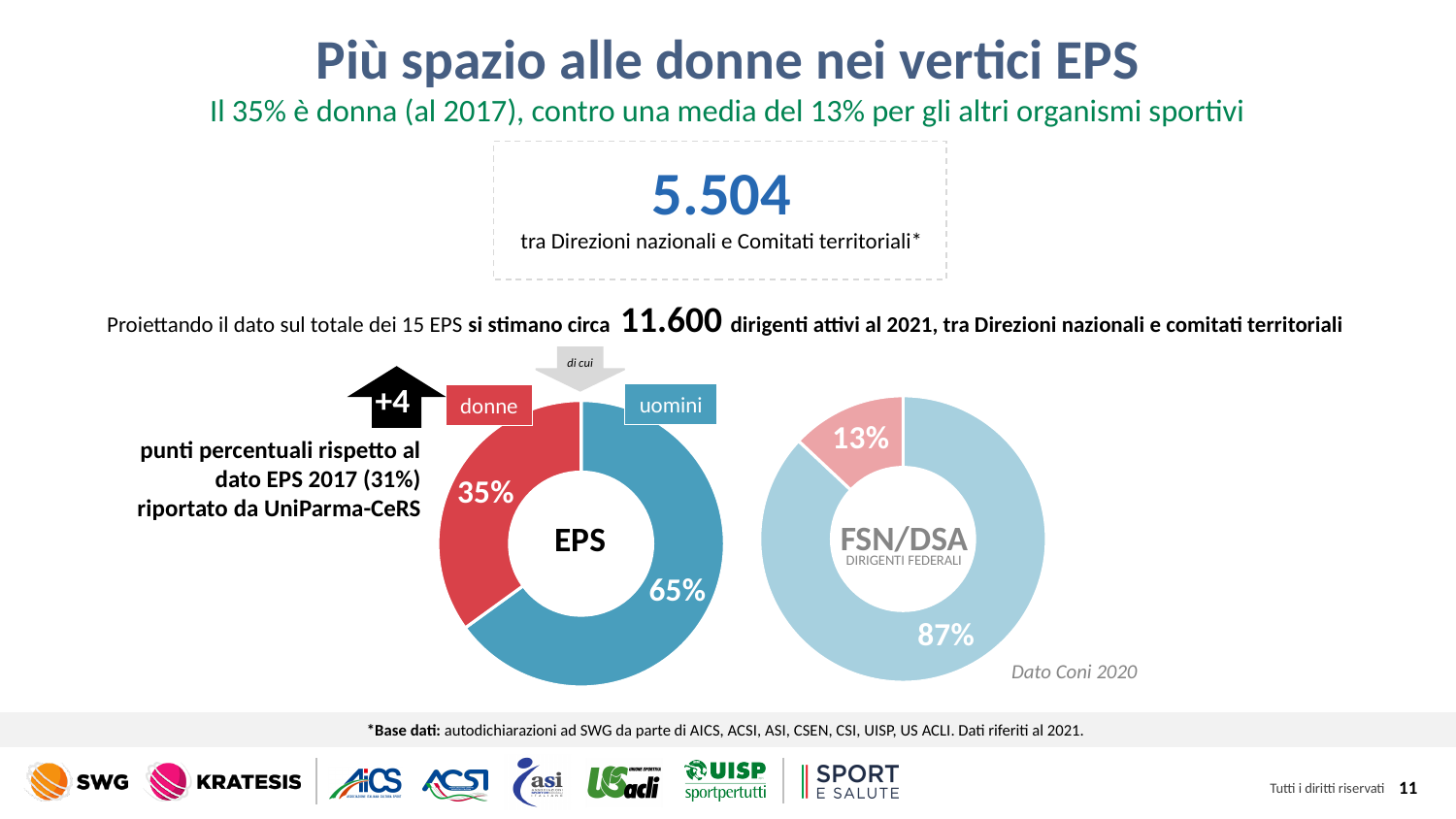
How many donut charts are shown on the slide? 2 In the EPS donut chart, which category has the larger share, donne or uomini? uomini In the EPS donut chart, what is the difference in percentage points between uomini and donne? 30 What label appears in the centre of the right-hand donut chart? FSN/DSA What is the difference in percentage points between the women's share in the EPS chart (35%) and the smaller slice in the FSN/DSA chart (13%)? 22 In the EPS donut chart, what percentage is shown for uomini? 65% In the EPS donut chart, what percentage is shown for donne? 35% How many slices does the EPS donut chart have? 2 In the FSN/DSA donut chart, what is the larger slice's percentage? 87% In the FSN/DSA donut chart, what is the smaller slice's percentage? 13% What source is cited below the FSN/DSA donut chart? Dato Coni 2020 What kind of chart is used to show the EPS and FSN/DSA data? Donut (pie) chart